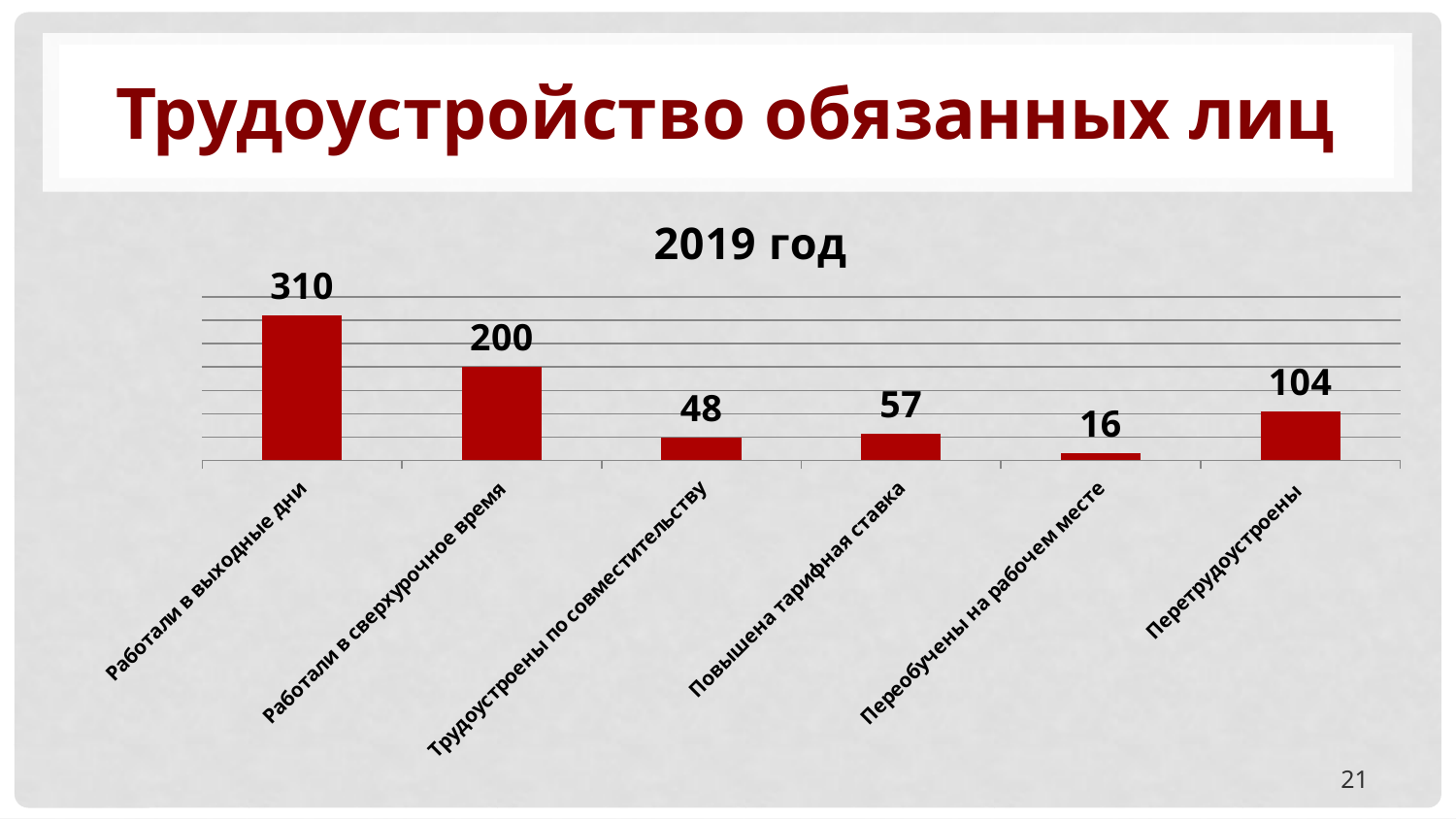
What is the difference between the values for "Повышена тарифная ставка" and "Трудоустроены по совместительству"? 9 What is the value for "Работали в выходные дни"? 310 What is the difference between the values for "Работали в выходные дни" and "Работали в сверхурочное время"? 110 Which is larger: the value for "Перетрудоустроены" or the value for "Трудоустроены по совместительству"? Перетрудоустроены What is the value for "Переобучены на рабочем месте"? 16 What is the title of the chart? 2019 год Which category has the highest value? Работали в выходные дни Which category has the lowest value? Переобучены на рабочем месте What is the value for "Перетрудоустроены"? 104 What kind of chart is shown on the slide? bar chart What is the value for "Повышена тарифная ставка"? 57 How many categories are shown in the chart? 6